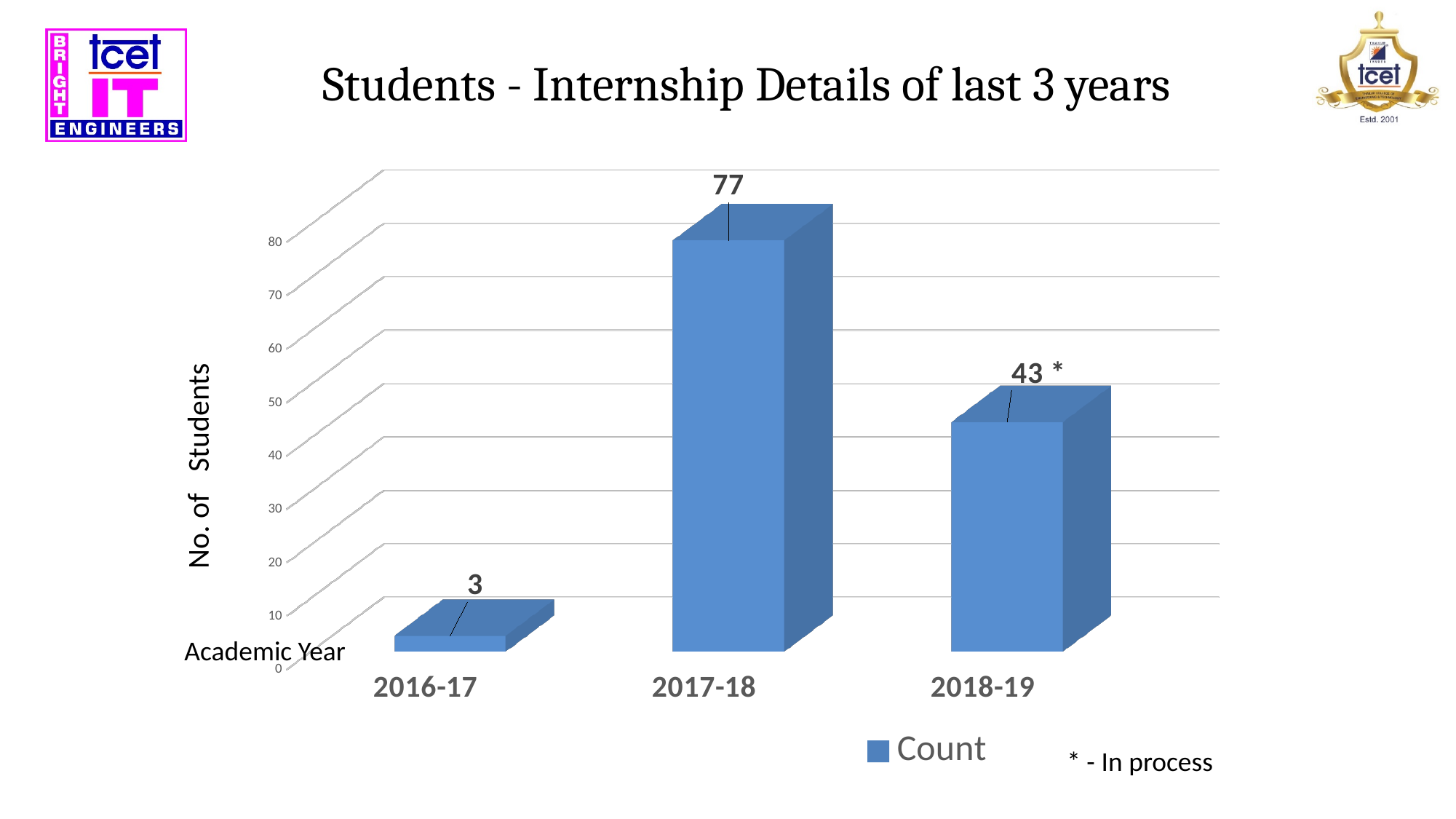
Which academic year has the highest number of students? 2017-18 What is the number of students for 2017-18? 77 What does the asterisk next to the 2018-19 value indicate? In process What is the number of students for 2016-17? 3 How many series does the legend list? 1 What is the number of students for 2018-19? 43 Which is larger, the value for 2017-18 or the value for 2018-19? 2017-18 Which academic year has the lowest number of students? 2016-17 What is the difference between the number of students in 2018-19 and 2016-17? 40 What is the difference between the number of students in 2017-18 and 2018-19? 34 How many academic years are shown on the chart? 3 What kind of chart is shown on the slide? bar chart